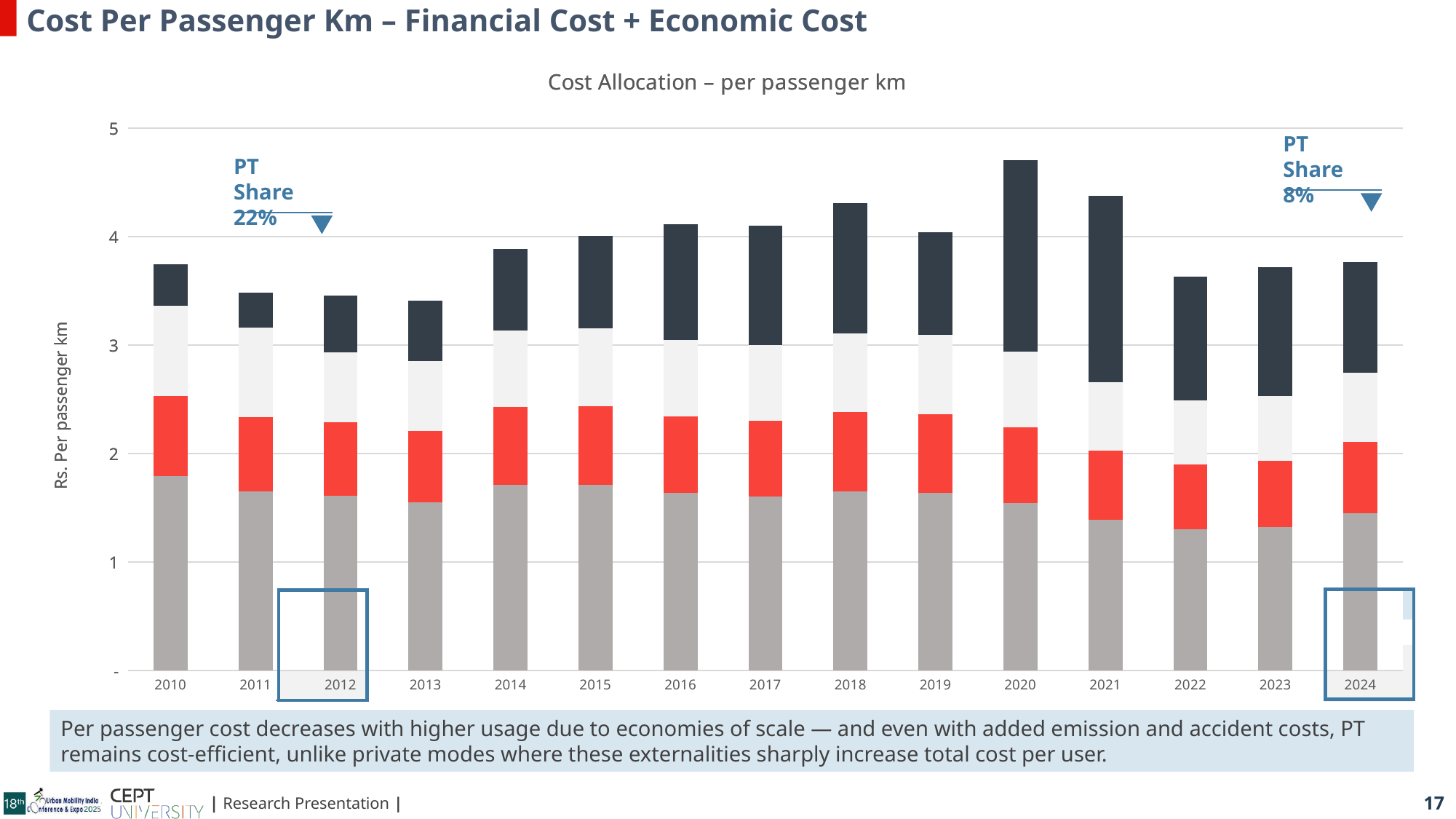
Is the total value for 2010 greater or less than 4? less What is the title of the chart? Cost Allocation – per passenger km Do the total bar heights rise or fall from 2013 to 2020? rise Is the total value for 2013 greater or less than 4? less Is the total value for 2020 greater or less than 4? greater Which year has the tallest stacked bar? 2020 What PT share is annotated above the 2024 bar? 8% What kind of chart is shown on the slide? Stacked bar chart How many years are shown on the x axis of the chart? 15 Which year has the larger total bar, 2020 or 2010? 2020